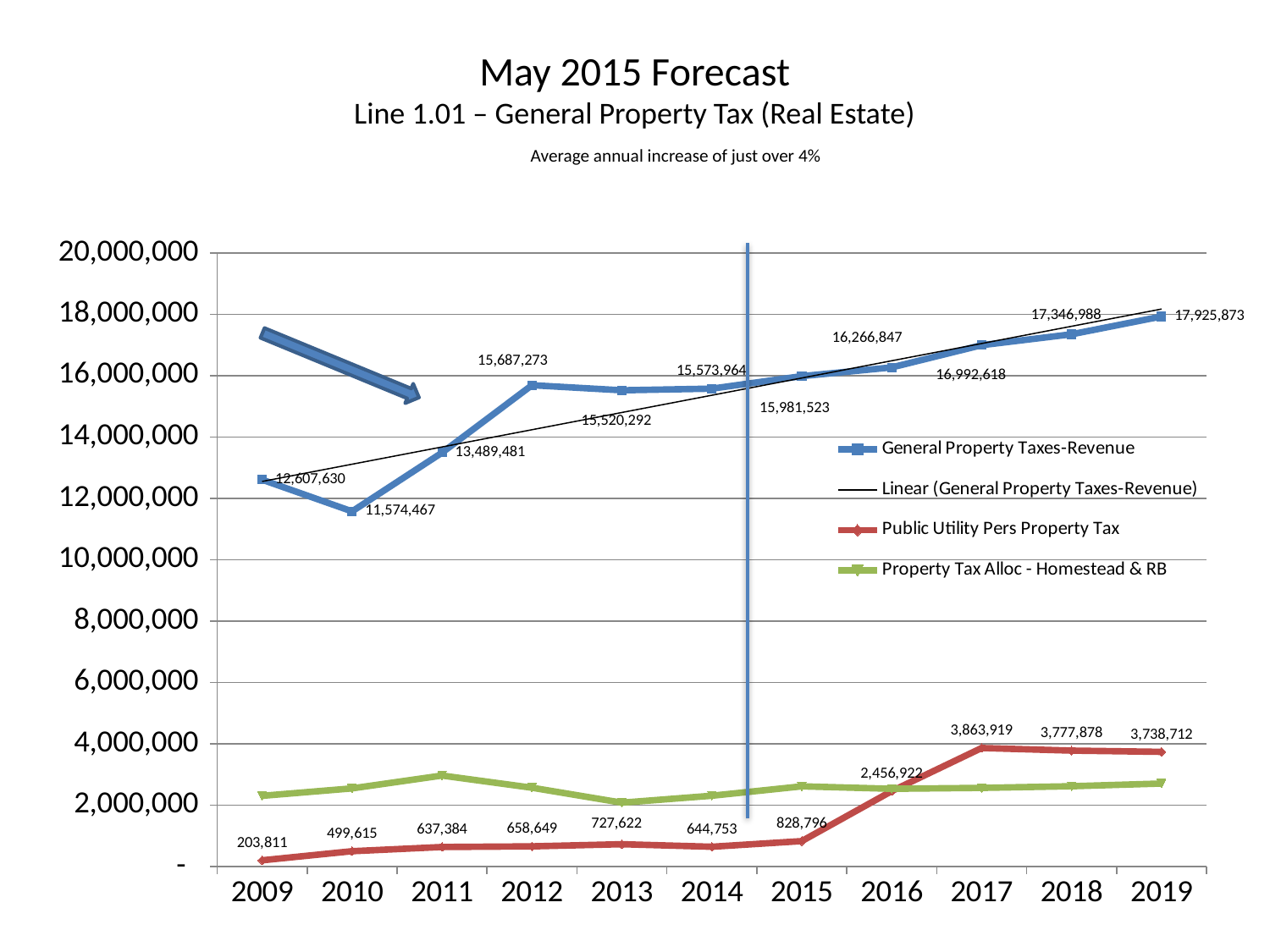
In which year is Public Utility Pers Property Tax highest? 2017 Is the value for Property Tax Alloc - Homestead & RB in 2011 greater or less than 2,000,000? greater By how much does General Property Taxes-Revenue in 2019 exceed its 2009 value? 5,318,243 What kind of chart is shown on the slide? line chart How many entries does the legend list? 4 What is the value of Public Utility Pers Property Tax in 2017? 3,863,919 What is the value of General Property Taxes-Revenue in 2010? 11,574,467 In which year is General Property Taxes-Revenue lowest? 2010 Which year has the higher General Property Taxes-Revenue, 2012 or 2013? 2012 Does Public Utility Pers Property Tax rise or fall from 2009 to 2017? rise What is the value of General Property Taxes-Revenue in 2019? 17,925,873 How many years are shown on the x axis? 11